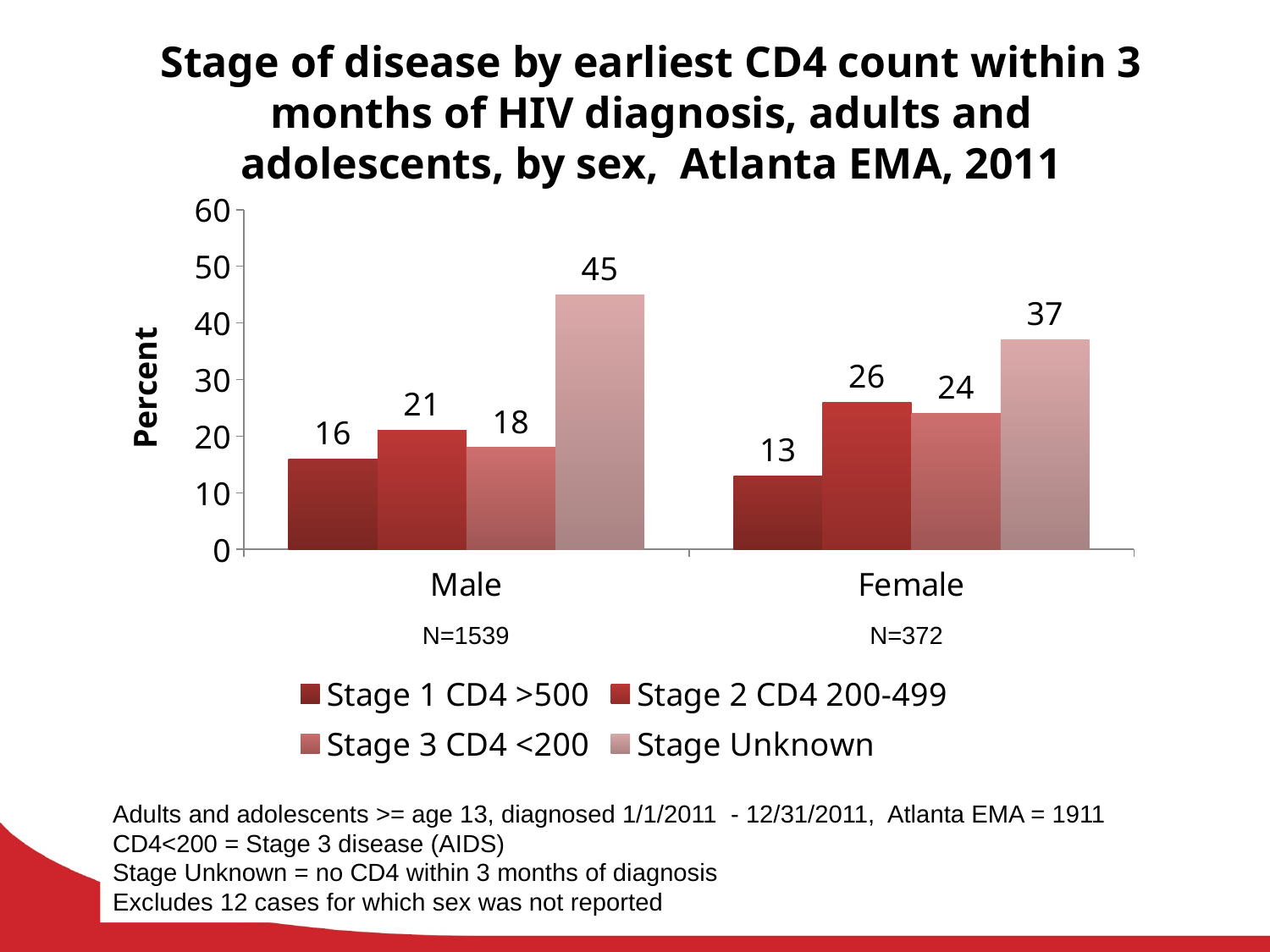
What is the label of the y axis? Percent Which stage has the lowest value among males? Stage 1 CD4 >500 Which stage has the highest value among females? Stage Unknown How many series does the legend list? 4 What is the value for Stage 1 CD4 >500 among females? 13 What is the value for Stage 3 CD4 <200 among males? 18 What is the value for Stage 2 CD4 200-499 among females? 26 What is the value for Stage Unknown among males? 45 What is the difference between the Stage Unknown values for males and females? 8 How many categories are shown on the x axis? 2 What kind of chart is shown on the slide? Bar chart Which is larger, Stage 2 CD4 200-499 for males or for females? Female